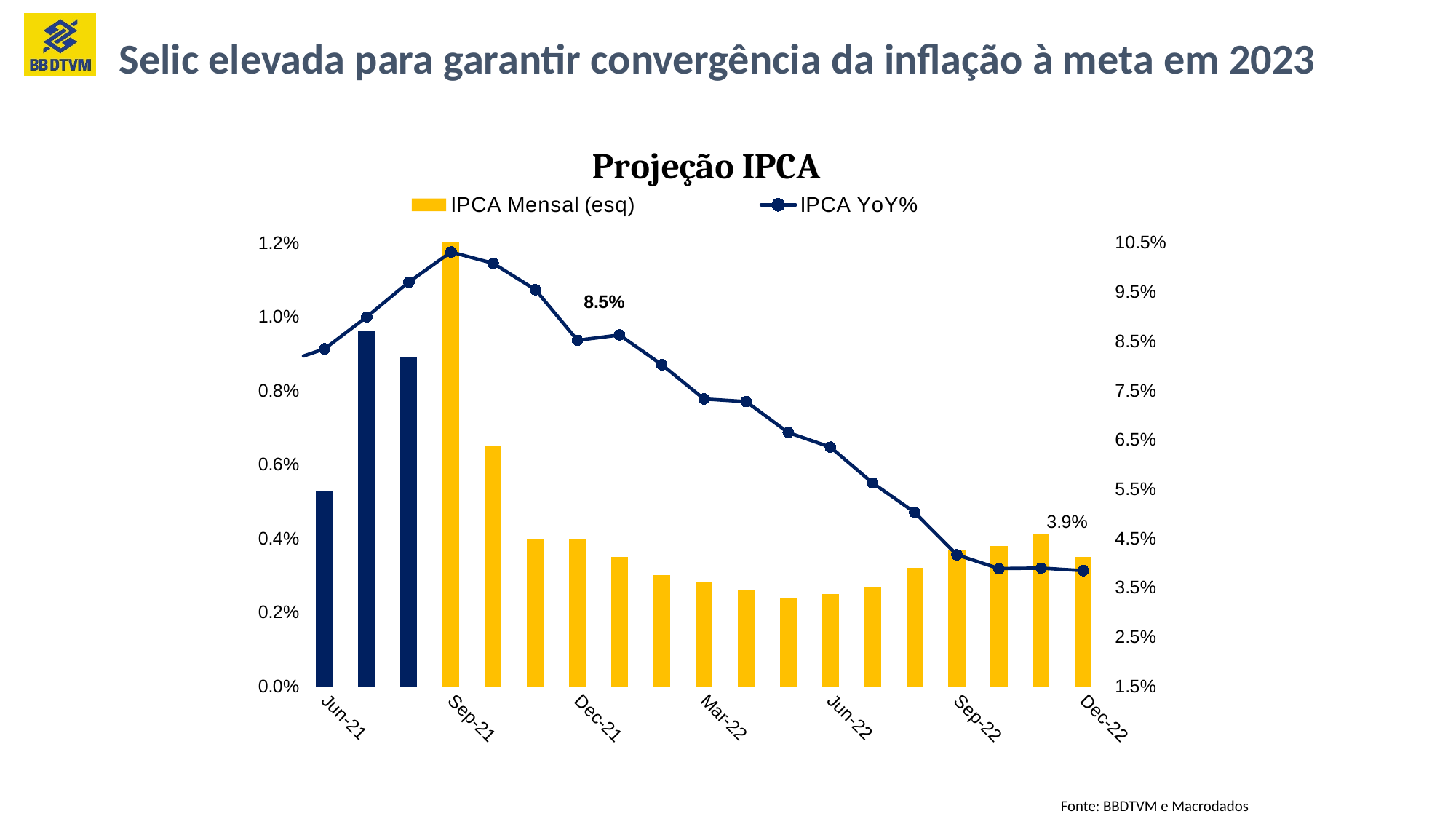
How many monthly bars are plotted in the chart? 19 Is the IPCA Mensal value for Jun-21 greater or less than 0.4%? greater Which month has the highest IPCA Mensal bar? Sep-21 What is the IPCA Mensal value for Sep-21? 1.2% What is the title of the chart? Projeção IPCA What is the IPCA Mensal value for Dec-21? 0.4% Does the IPCA YoY% line rise or fall from Sep-21 to Dec-22? fall What kind of chart is shown on the slide? Combined bar and line chart Which is larger, the IPCA Mensal bar for Jul-21 or for Jun-21? Jul-21 Is the IPCA YoY% value for Jun-22 greater or less than 7.5%? less What value is labelled on the IPCA YoY% line near Dec-22? 3.9% How many series does the chart legend list? 2